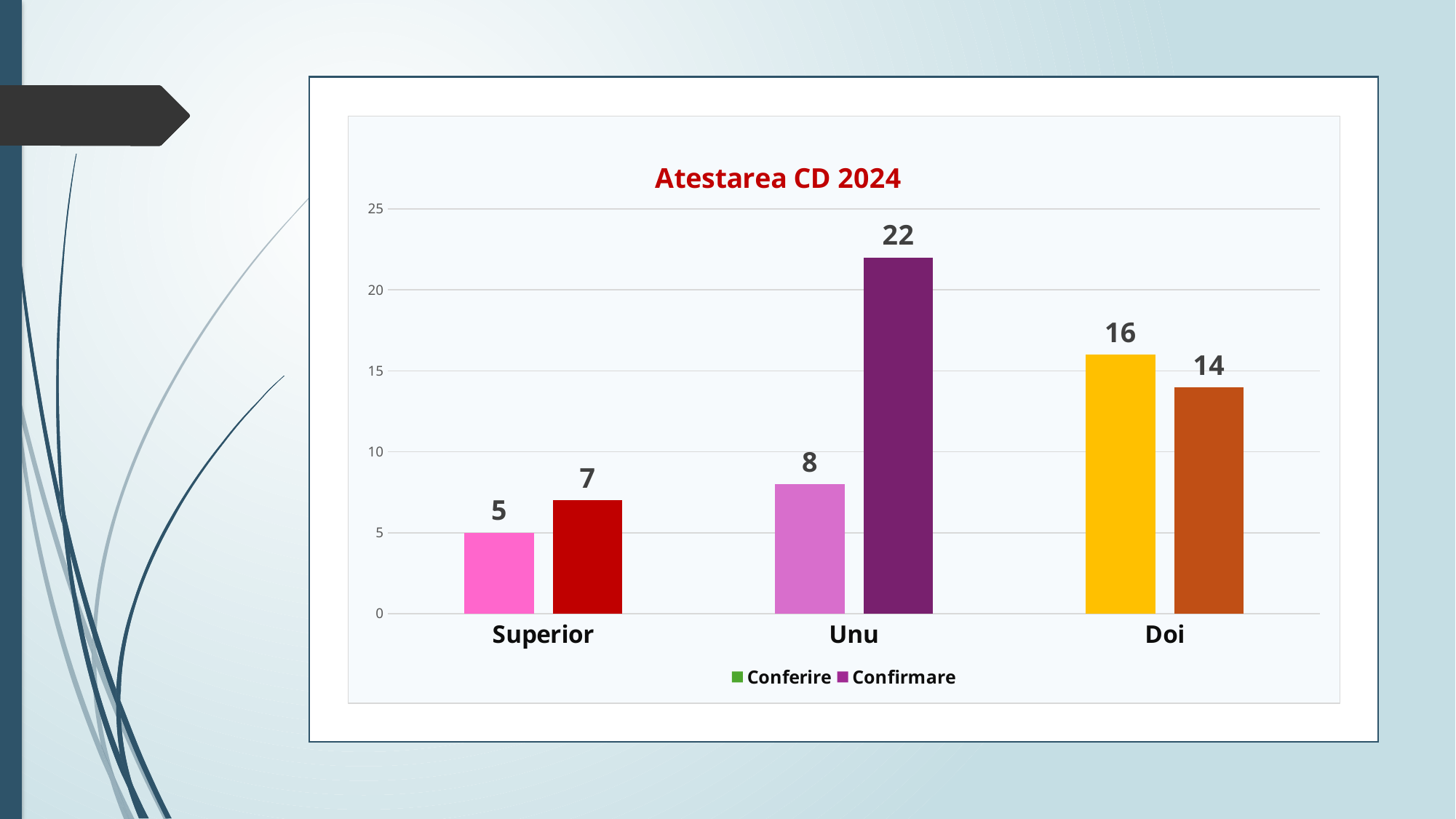
For Doi, which is larger: Conferire or Confirmare? Conferire Which category has the lowest Conferire value? Superior What is the Conferire value for Doi? 16 What is the Confirmare value for Unu? 22 How many categories are shown on the x axis? 3 What is the title of the chart? Atestarea CD 2024 How many series does the legend list? 2 Which category has the highest Confirmare value? Unu Does the Conferire value rise or fall from Superior to Doi? rise What is the difference between the Confirmare and Conferire values for Unu? 14 What type of chart is shown on the slide? bar chart What is the Conferire value for Superior? 5